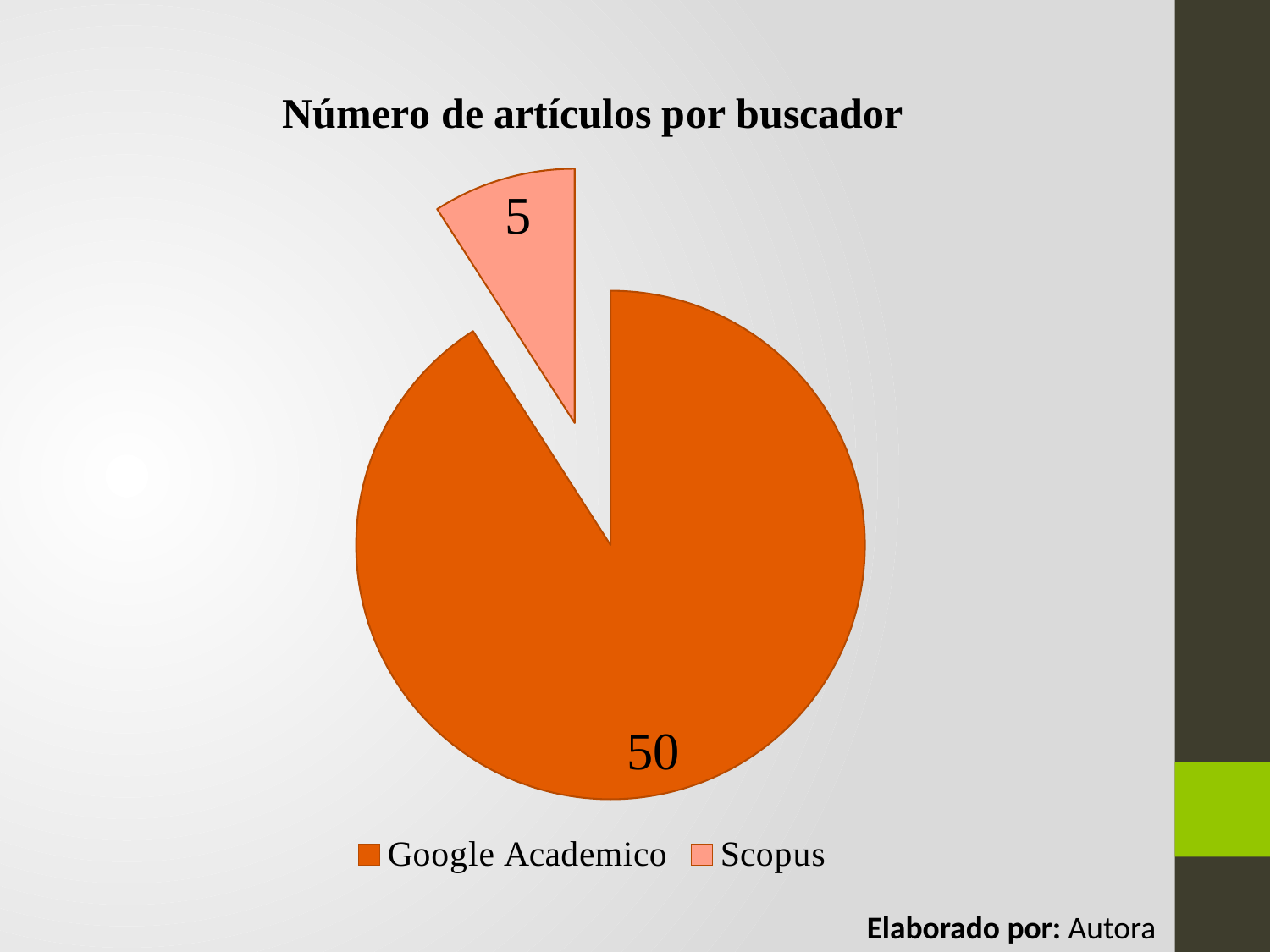
What kind of chart is shown on the slide? Pie chart Which category has the smallest slice? Scopus What is the difference between the values for Google Academico and Scopus? 45 What is the value for Google Academico? 50 What is the value for Scopus? 5 What is the total of all slices in the pie chart? 55 What is the title of the chart? Número de artículos por buscador How many categories does the pie chart show? 2 Which category is shown in the lighter, salmon-coloured slice? Scopus Which category has the largest slice? Google Academico Which is larger, the value for Google Academico or the value for Scopus? Google Academico